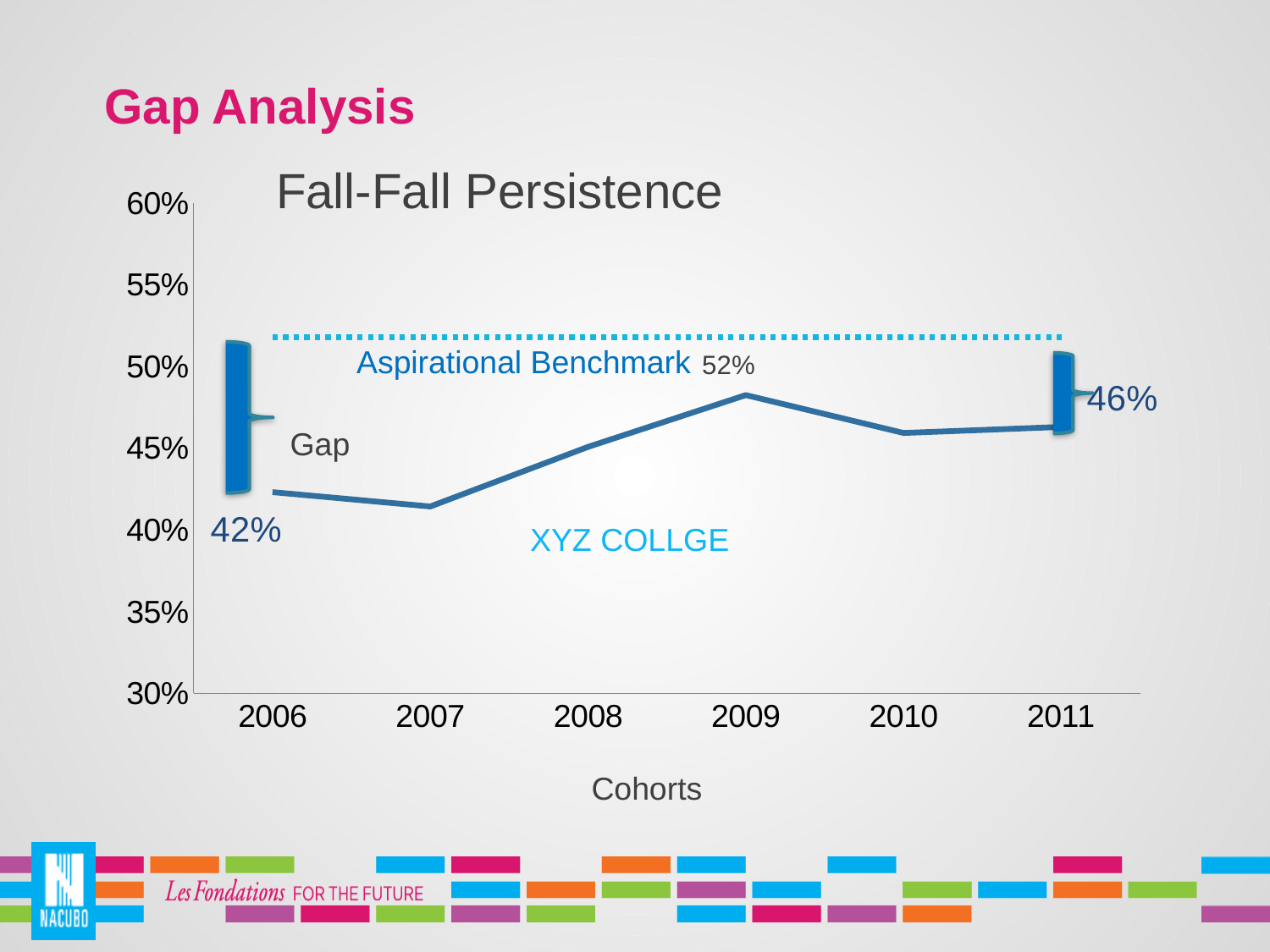
What is the Fall-Fall Persistence value for the 2006 cohort? 42% What is the title of the x axis? Cohorts What value is shown for the Aspirational Benchmark? 52% Which cohort has the lowest Fall-Fall Persistence for XYZ College? 2007 What is the Fall-Fall Persistence value for the 2011 cohort? 46% By how many percentage points did XYZ College's persistence rise from the 2006 cohort to the 2011 cohort? 4 percentage points How far below the Aspirational Benchmark is the 2011 cohort value? 6 percentage points Is the value for the 2009 cohort greater or less than 45%? greater Which cohort has the highest Fall-Fall Persistence for XYZ College? 2009 Is the value for the 2007 cohort greater or less than 45%? less What kind of chart is used to show Fall-Fall Persistence? Line chart How many cohorts are shown on the x axis? 6